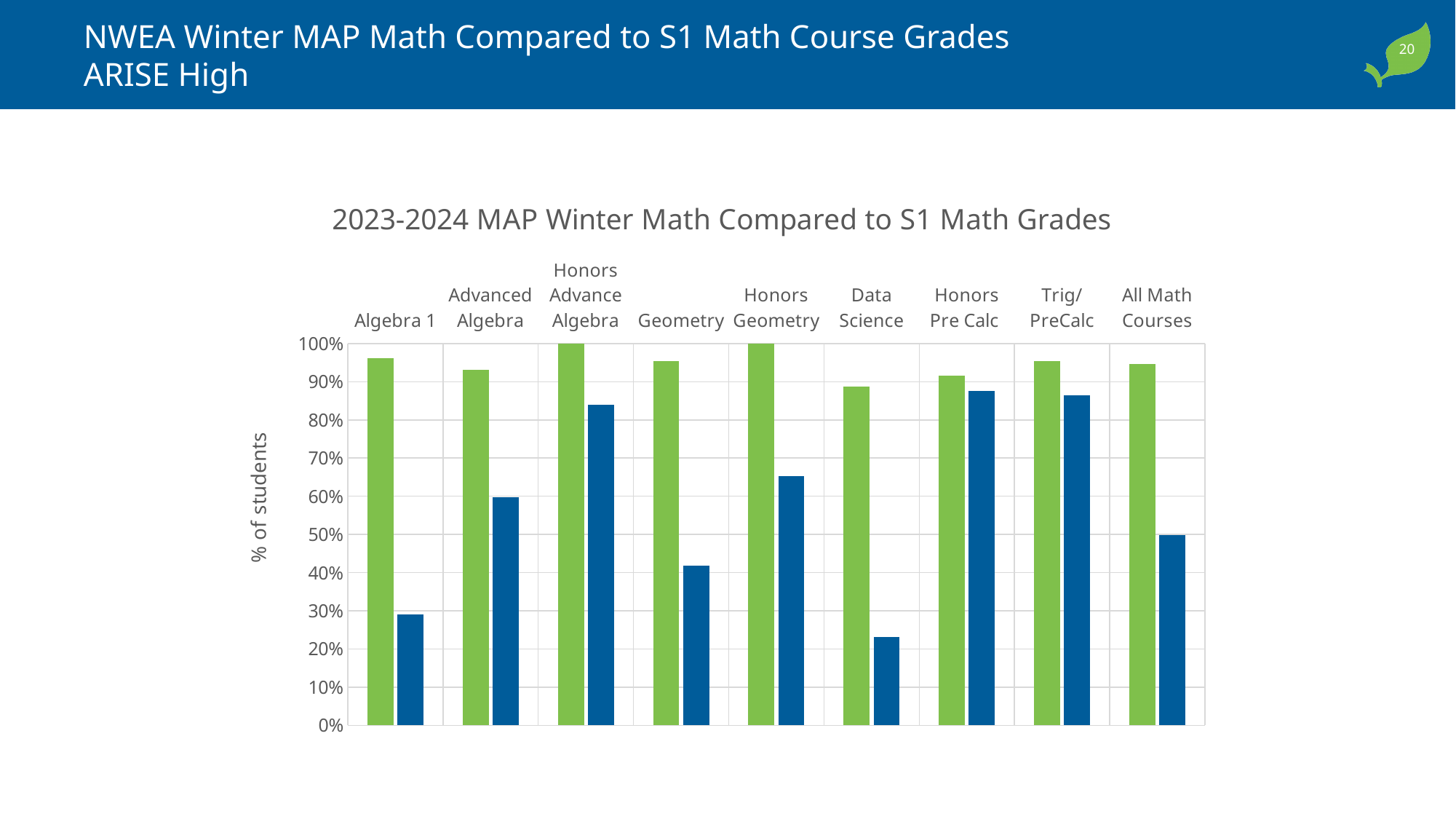
What is the label on the vertical axis of the chart? % of students Is the blue bar for Data Science greater or less than 30%? less What is the value of the green bar for Honors Geometry? 100% How many course categories are shown on the x axis of the chart? 9 Which category has the lowest blue bar? Data Science Which has the larger blue bar, Algebra 1 or Advanced Algebra? Advanced Algebra Which has the larger blue bar, Geometry or Honors Geometry? Honors Geometry What kind of chart is shown on the slide? bar chart Is the blue bar for Honors Pre Calc greater or less than 80%? greater Is the blue bar for Algebra 1 greater or less than 40%? less What is the title of the chart? 2023-2024 MAP Winter Math Compared to S1 Math Grades